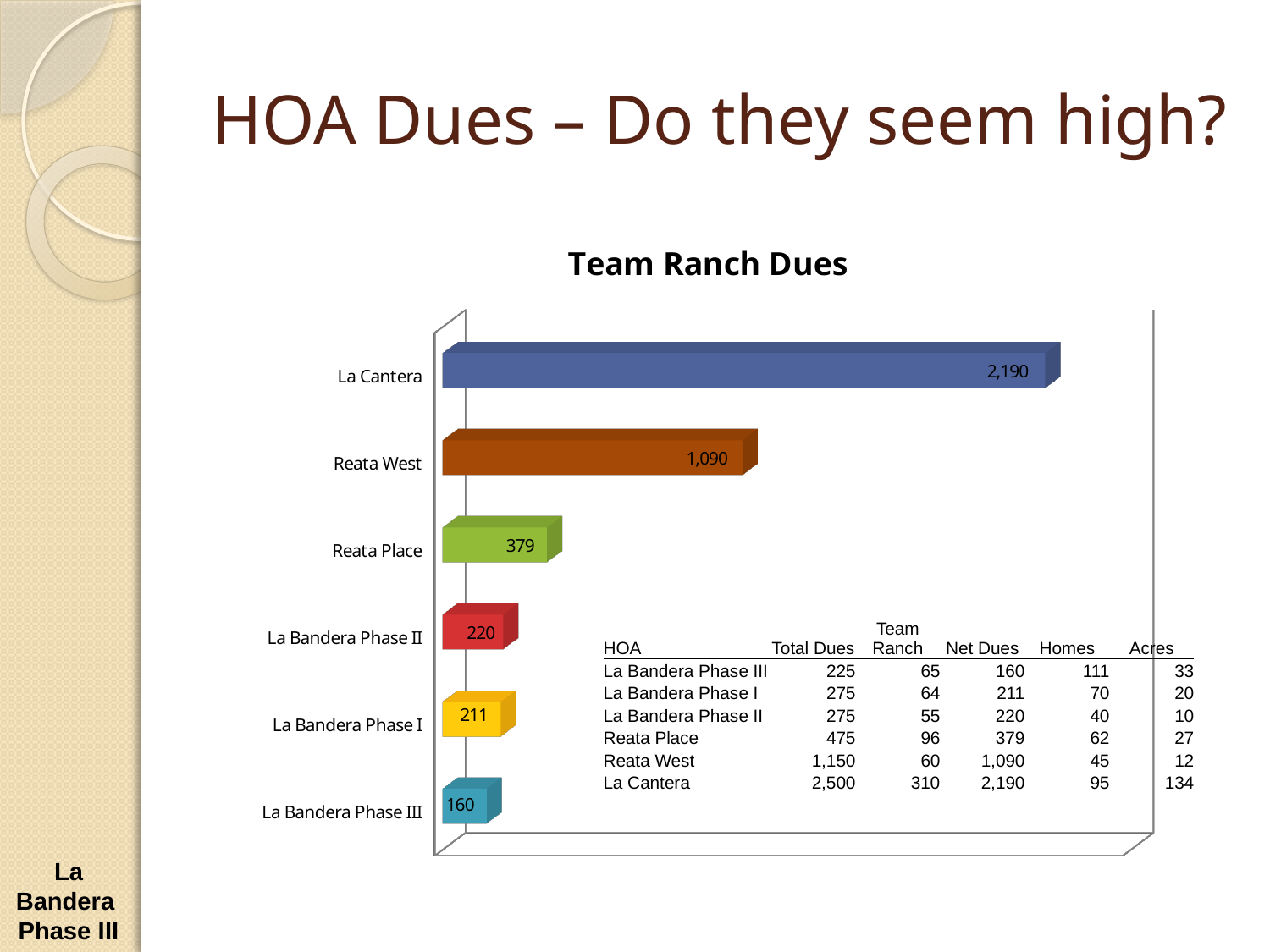
Which category has the highest value in the Team Ranch Dues chart? La Cantera What is the difference between the values for La Bandera Phase II and La Bandera Phase I in the Team Ranch Dues chart? 9 What is the value for Reata West in the Team Ranch Dues chart? 1,090 What is the value for La Bandera Phase III in the Team Ranch Dues chart? 160 What is the value for La Cantera in the Team Ranch Dues chart? 2,190 What is the difference between the values for La Cantera and Reata West in the Team Ranch Dues chart? 1,100 How many categories are shown in the Team Ranch Dues chart? 6 Which category has the lowest value in the Team Ranch Dues chart? La Bandera Phase III What kind of chart is the Team Ranch Dues chart? Bar chart What is the value for Reata Place in the Team Ranch Dues chart? 379 What is the title of the chart on the slide? Team Ranch Dues Which is larger in the Team Ranch Dues chart, Reata Place or La Bandera Phase II? Reata Place